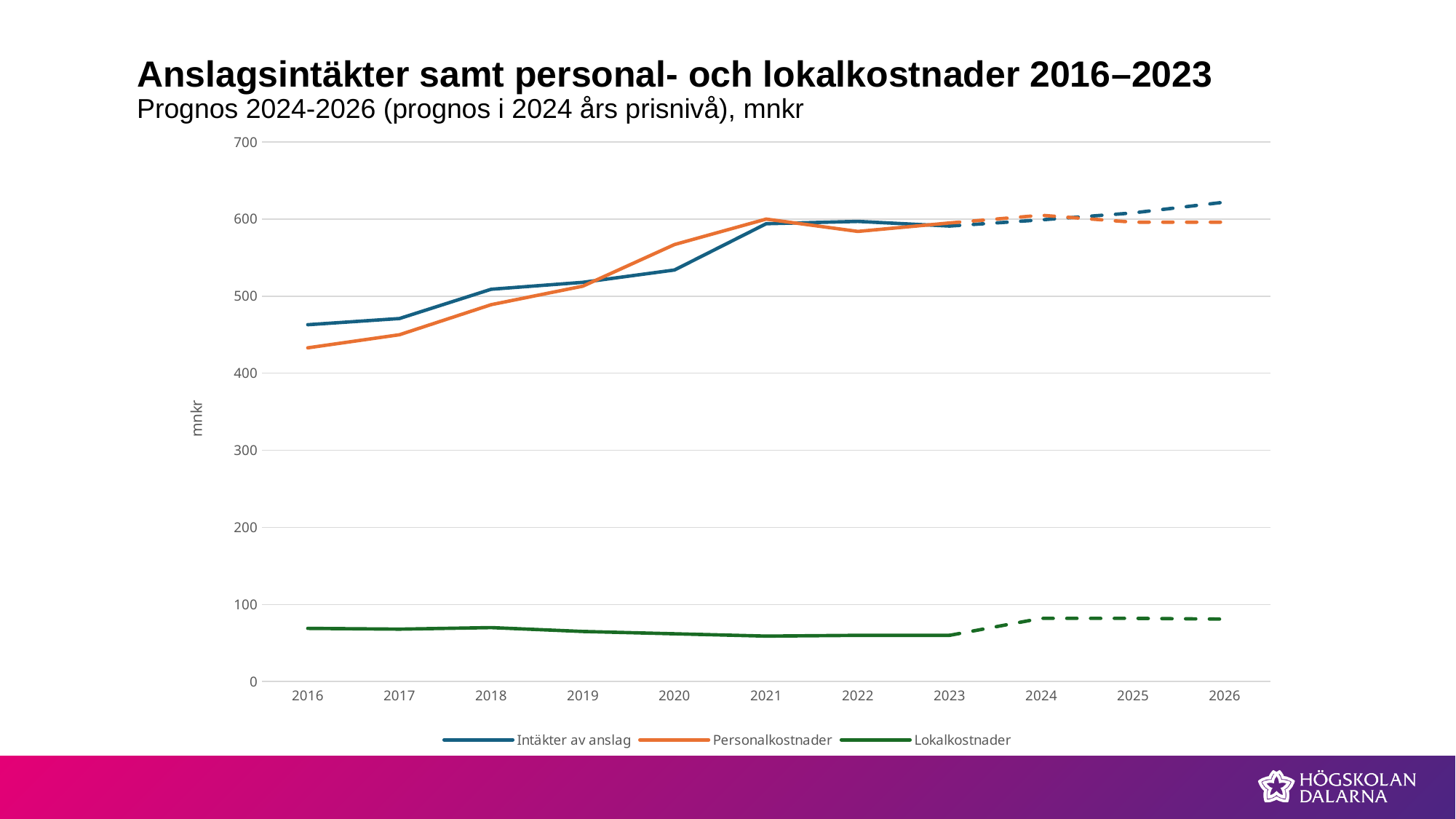
Is the value for Intäkter av anslag in 2026 greater or less than 600? greater What kind of chart is shown on the slide? line chart Is the value for Lokalkostnader in 2024 greater or less than 100? less Is the value for Personalkostnader in 2020 greater or less than 500? greater How many series does the legend list? 3 In 2020, which is larger: Intäkter av anslag or Personalkostnader? Personalkostnader How many years are shown on the x axis? 11 What unit is shown on the y axis label? mnkr In 2016, which is larger: Intäkter av anslag or Personalkostnader? Intäkter av anslag Which series has the lowest values across all years? Lokalkostnader Do the values for Personalkostnader rise or fall from 2016 to 2021? rise